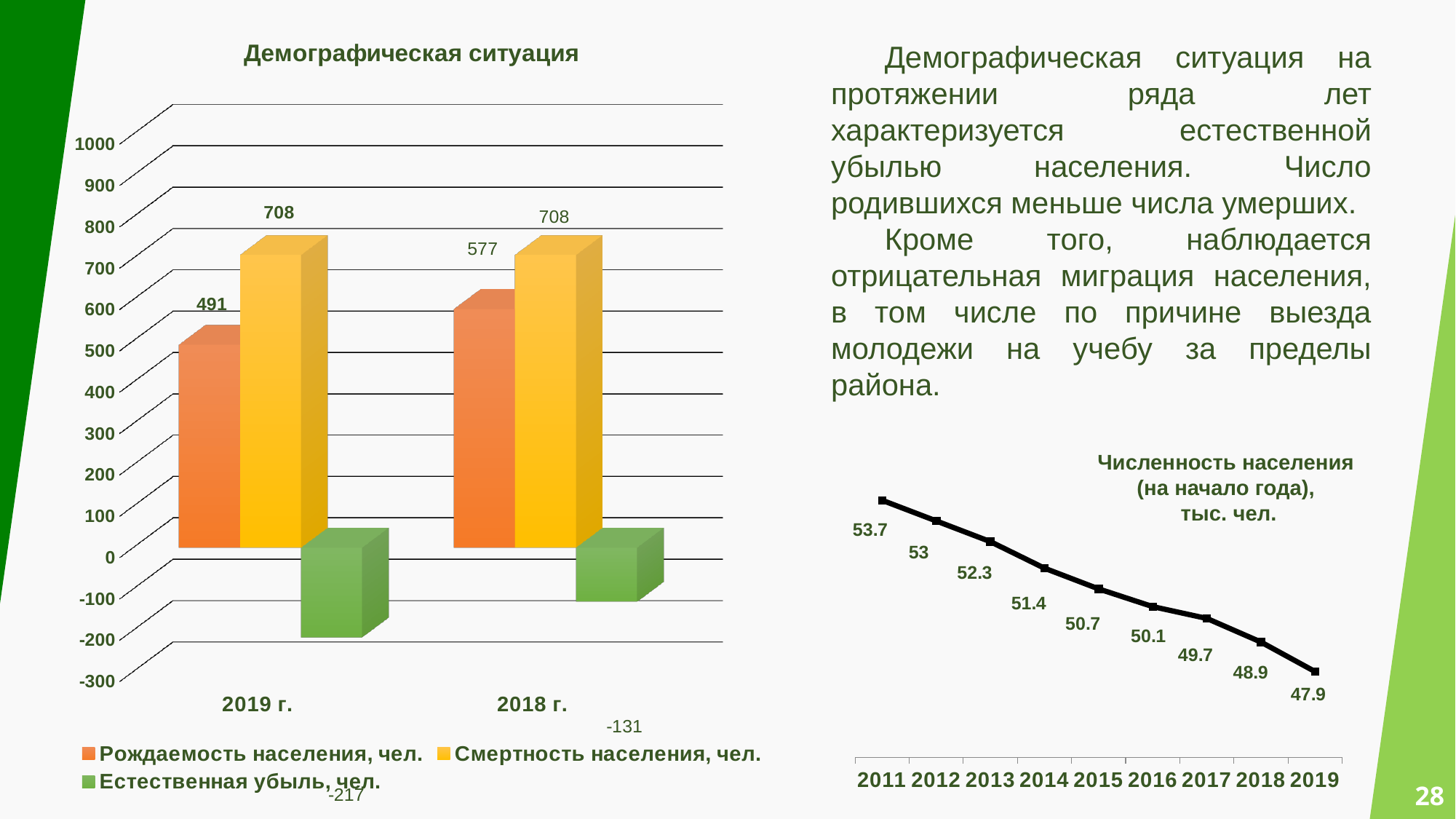
In the chart titled "Численность населения (на начало года), тыс. чел.", which year has the highest value? 2011 In the chart titled "Демографическая ситуация", what is the difference between "Рождаемость населения, чел." in 2018 г. and in 2019 г.? 86 In the chart titled "Демографическая ситуация", what kind of chart is it? Bar chart In the chart titled "Демографическая ситуация", what is the value of "Рождаемость населения, чел." for 2019 г.? 491 In the chart titled "Демографическая ситуация", which is larger for 2019 г.: "Рождаемость населения, чел." or "Смертность населения, чел."? Смертность населения, чел. In the chart titled "Численность населения (на начало года), тыс. чел.", which year has the lowest value? 2019 In the chart titled "Численность населения (на начало года), тыс. чел.", do the values rise or fall from 2011 to 2019? Fall In the chart titled "Демографическая ситуация", what is the value of "Смертность населения, чел." for 2018 г.? 708 In the chart titled "Численность населения (на начало года), тыс. чел.", how many years are plotted? 9 In the chart titled "Демографическая ситуация", what colour represents "Естественная убыль, чел."? Green In the chart titled "Численность населения (на начало года), тыс. чел.", what is the value for 2014? 51.4 In the chart titled "Демографическая ситуация", how many series does the legend list? 3